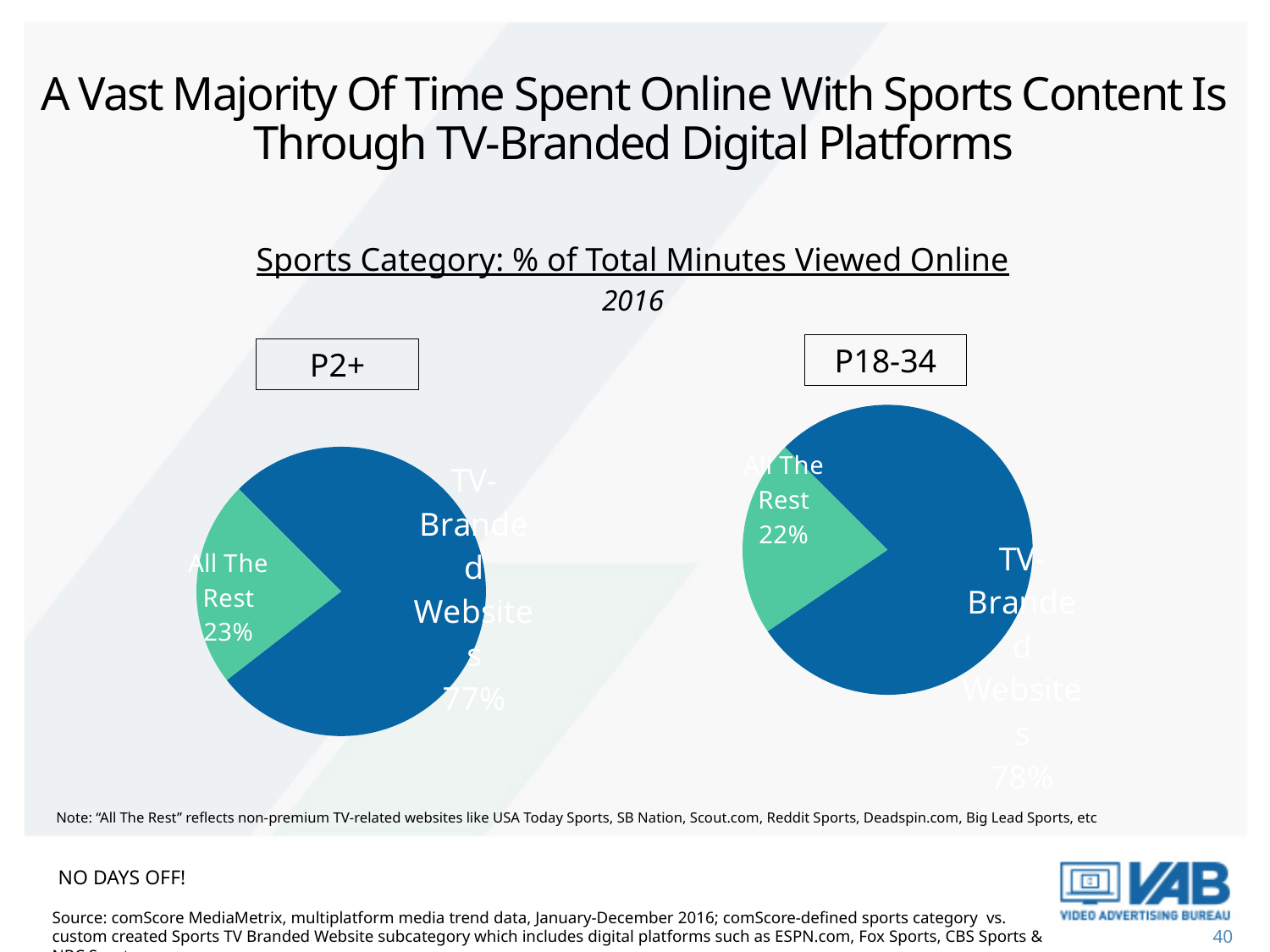
In the P2+ pie chart, what is the difference in percentage points between TV-Branded Websites and All The Rest? 54 In the P18-34 pie chart, what share is attributed to TV-Branded Websites? 78% How many slices does the P18-34 pie chart have? 2 In the P2+ pie chart, what share of total minutes viewed online is attributed to All The Rest? 23% In the P18-34 pie chart, what share of total minutes viewed online is attributed to All The Rest? 22% In the P18-34 pie chart, which slice is the smallest? All The Rest What type of chart is used on this slide? Pie chart In the P2+ pie chart, which slice is the largest? TV-Branded Websites How many pie charts are shown on the slide? 2 In the P2+ pie chart, what share is attributed to TV-Branded Websites? 77% What year do the pie charts on this slide cover? 2016 Which is larger: the All The Rest share for P2+ or the All The Rest share for P18-34? P2+